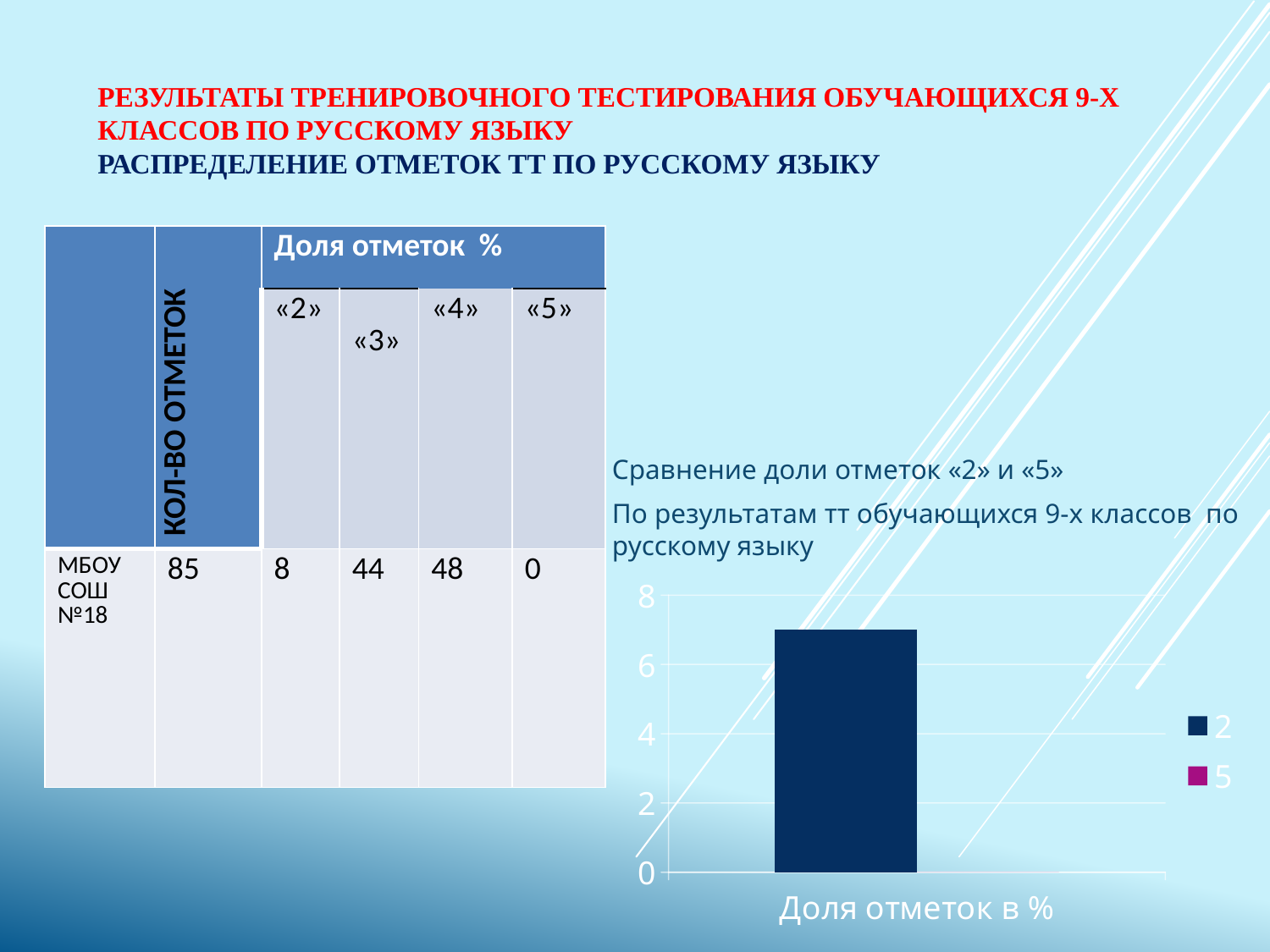
How many categories are shown on the x axis of the chart? 1 Is the value for series 2 in the chart greater or less than 4? greater What are the entries in the chart legend? 2 and 5 How many series does the chart legend list? 2 What is the highest tick value shown on the chart's vertical axis? 8 Which series has the lowest value in the chart? 5 Is the value for series 2 in the chart greater or less than 6? greater Which series has the highest value in the chart? 2 Which series has the higher bar in the chart, 2 or 5? 2 What kind of chart is shown on the slide? bar chart What is the category label on the x axis of the chart? Доля отметок в %